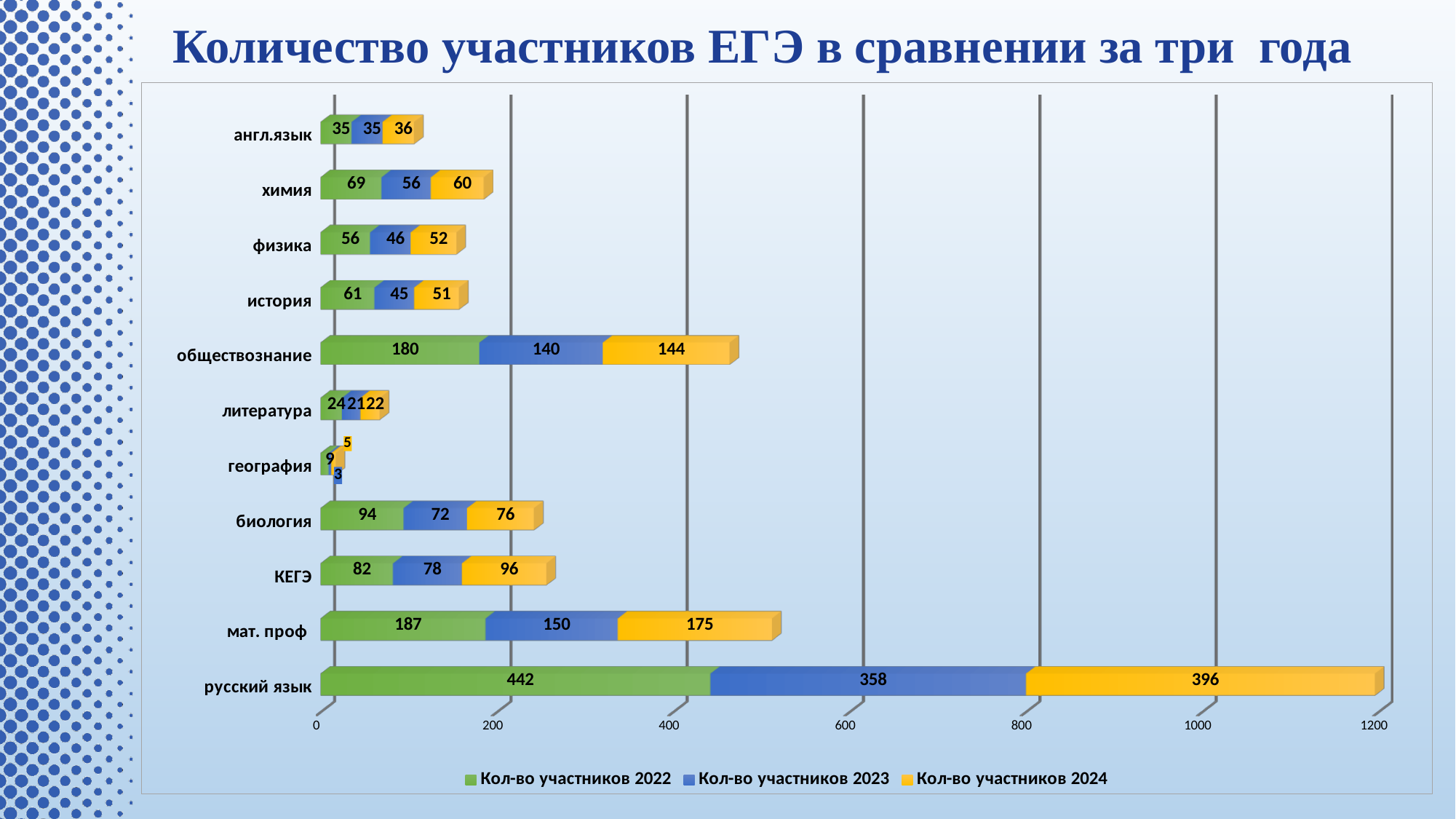
Which category has the highest value in the series Кол-во участников 2024? русский язык Which category has the lowest value in the series Кол-во участников 2023? география What is the value for обществознание in the series Кол-во участников 2024? 144 How many series does the legend list? 3 What is the value for КЕГЭ in the series Кол-во участников 2023? 78 What is the value for русский язык in the series Кол-во участников 2022? 442 Which is larger for биология: the value for Кол-во участников 2022 or Кол-во участников 2024? Кол-во участников 2022 What is the difference between the 2022 and 2023 values for мат. проф? 37 How many categories are shown on the y axis? 11 What is the total of the stacked bar for химия? 185 What kind of chart is shown on the slide? Stacked bar chart What is the title of the slide? Количество участников ЕГЭ в сравнении за три года